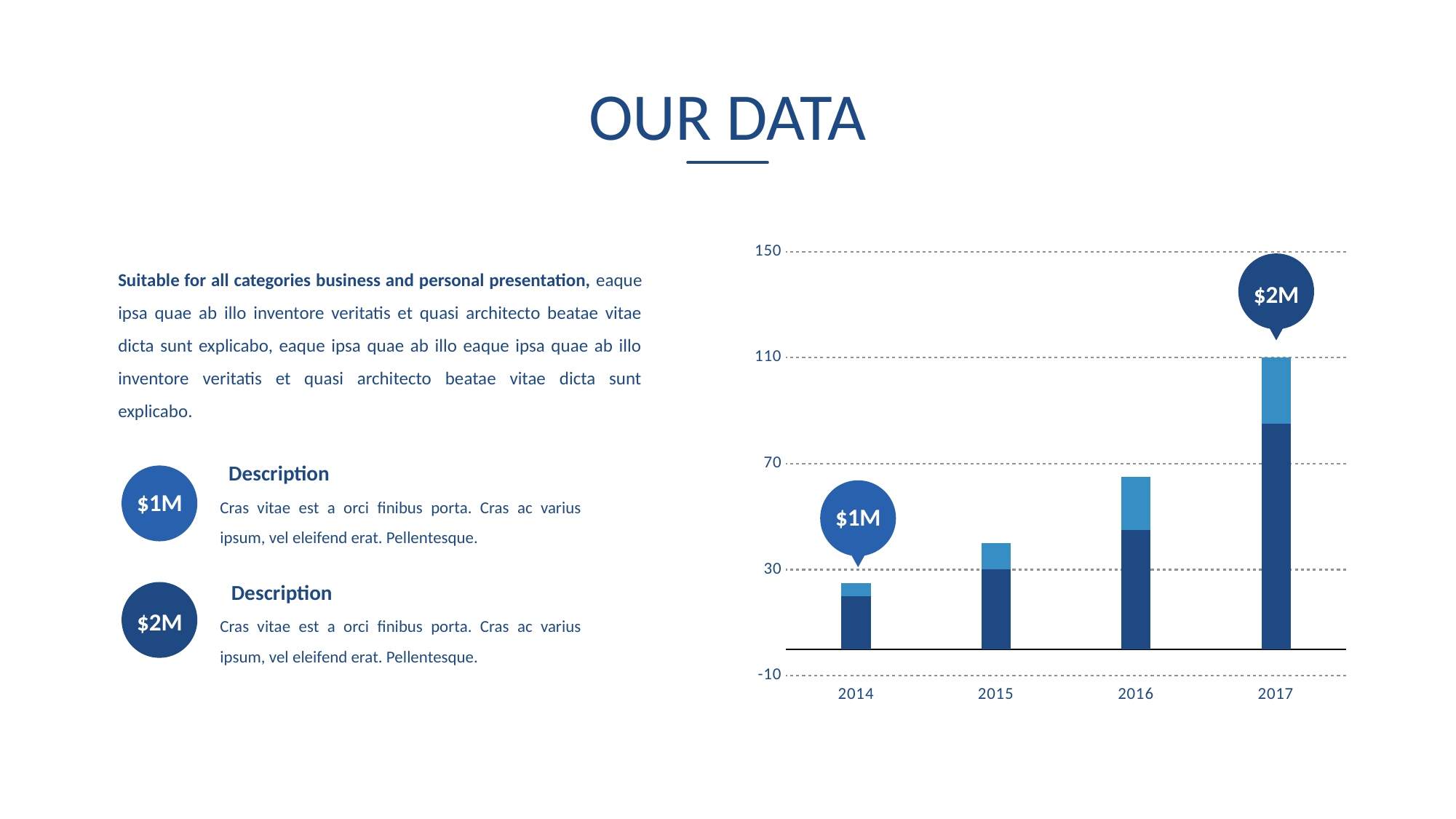
How many years are shown on the x axis of the chart? 4 Which bar is taller, 2015 or 2016? 2016 Which year has the tallest bar in the chart? 2017 Is the total height of the 2015 bar greater or less than 30? greater What label is shown in the callout above the 2017 bar? $2M What is the title of the slide containing the chart? OUR DATA Which year has the shortest bar in the chart? 2014 What kind of chart is shown on the slide? bar chart Do the bar heights rise or fall from 2014 to 2017? rise Is the total height of the 2014 bar greater or less than 30? less Is the total height of the 2016 bar greater or less than 70? less